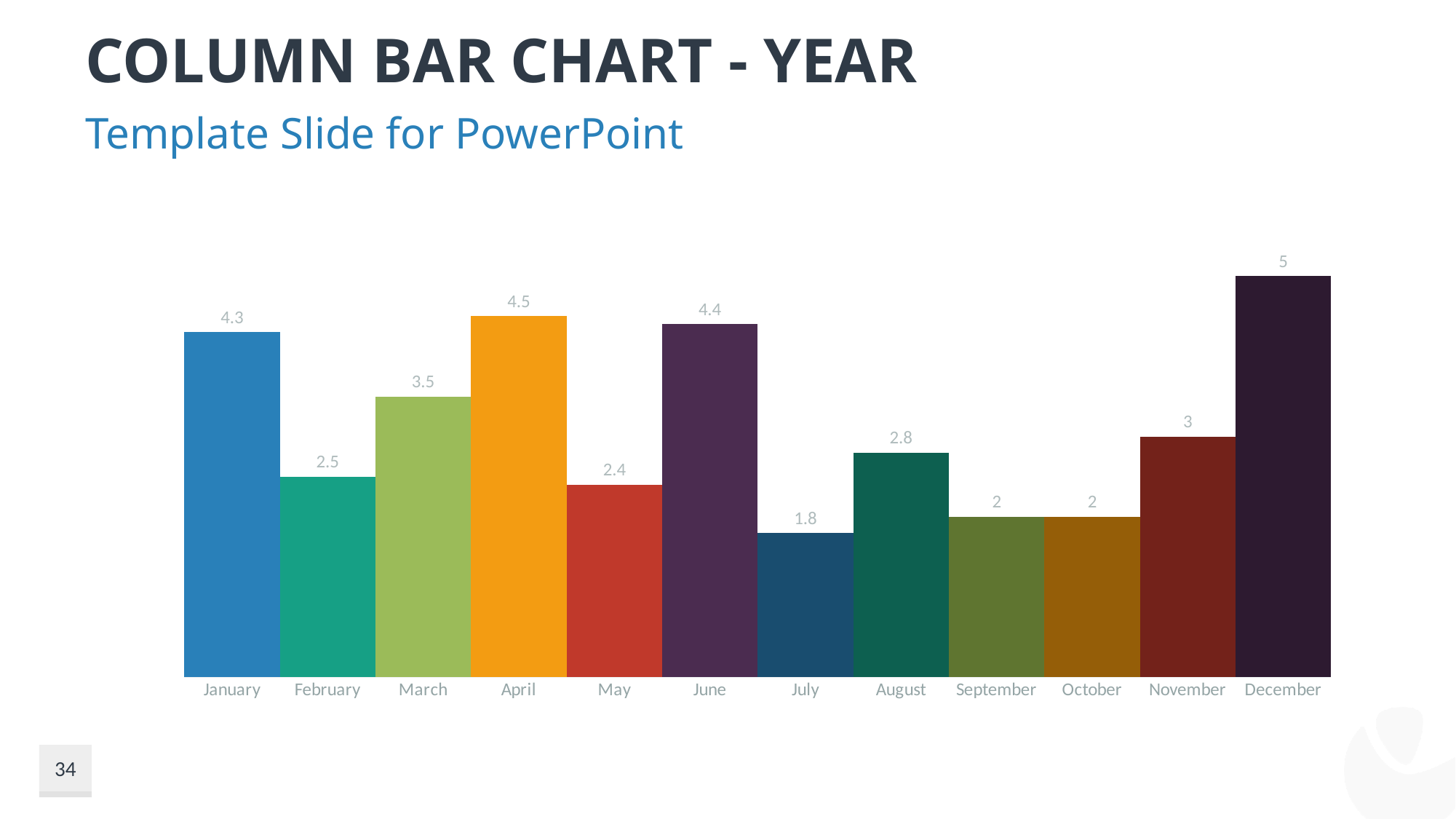
What is the value for November? 3 What is the difference between the values for March and February? 1 What kind of chart is shown on the slide? Bar chart Which is larger, the value for May or the value for February? February Which month has the highest value? December What is the title of the slide? COLUMN BAR CHART - YEAR Which month has the lowest value? July Which is larger, the value for June or the value for August? June What is the value for July? 1.8 What is the difference between the values for December and January? 0.7 How many months are shown on the x axis? 12 What is the value for April? 4.5